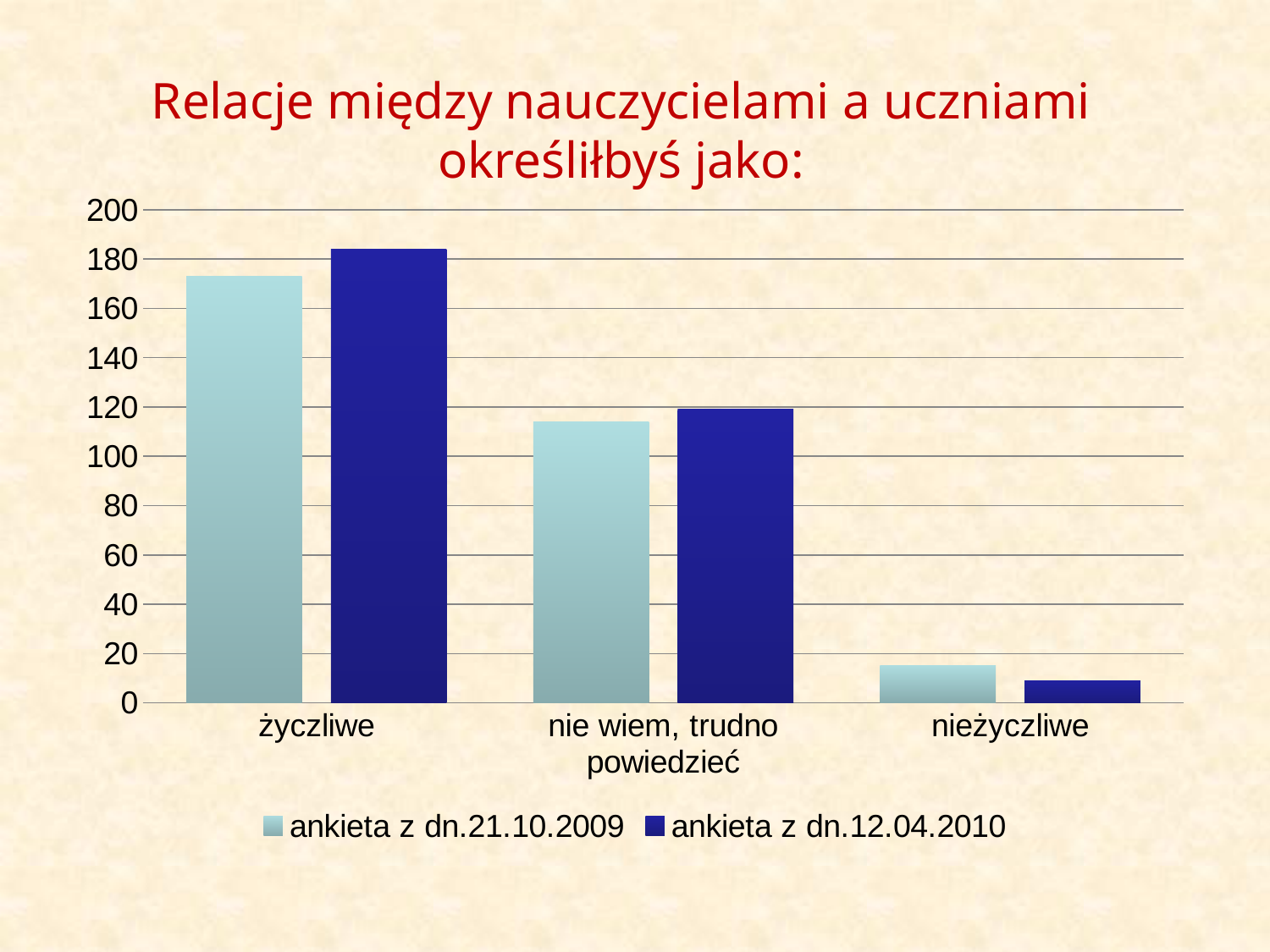
How many series does the legend list? 2 How many categories are shown on the x axis? 3 What is the title of the chart? Relacje między nauczycielami a uczniami określiłbyś jako: Which category has the lowest value for the series 'ankieta z dn.21.10.2009'? nieżyczliwe What kind of chart is shown on the slide? bar chart For the category 'nieżyczliwe', which series has the larger value: 'ankieta z dn.21.10.2009' or 'ankieta z dn.12.04.2010'? ankieta z dn.21.10.2009 Is the value for 'nie wiem, trudno powiedzieć' in the series 'ankieta z dn.12.04.2010' greater or less than 140? less Is the value for 'nieżyczliwe' in the series 'ankieta z dn.21.10.2009' greater or less than 20? less Do the values for the series 'ankieta z dn.12.04.2010' rise or fall from left to right along the x axis? fall Is the value for 'życzliwe' in the series 'ankieta z dn.21.10.2009' greater or less than 160? greater For the category 'życzliwe', which series has the larger value: 'ankieta z dn.21.10.2009' or 'ankieta z dn.12.04.2010'? ankieta z dn.12.04.2010 Which category has the highest value for the series 'ankieta z dn.12.04.2010'? życzliwe